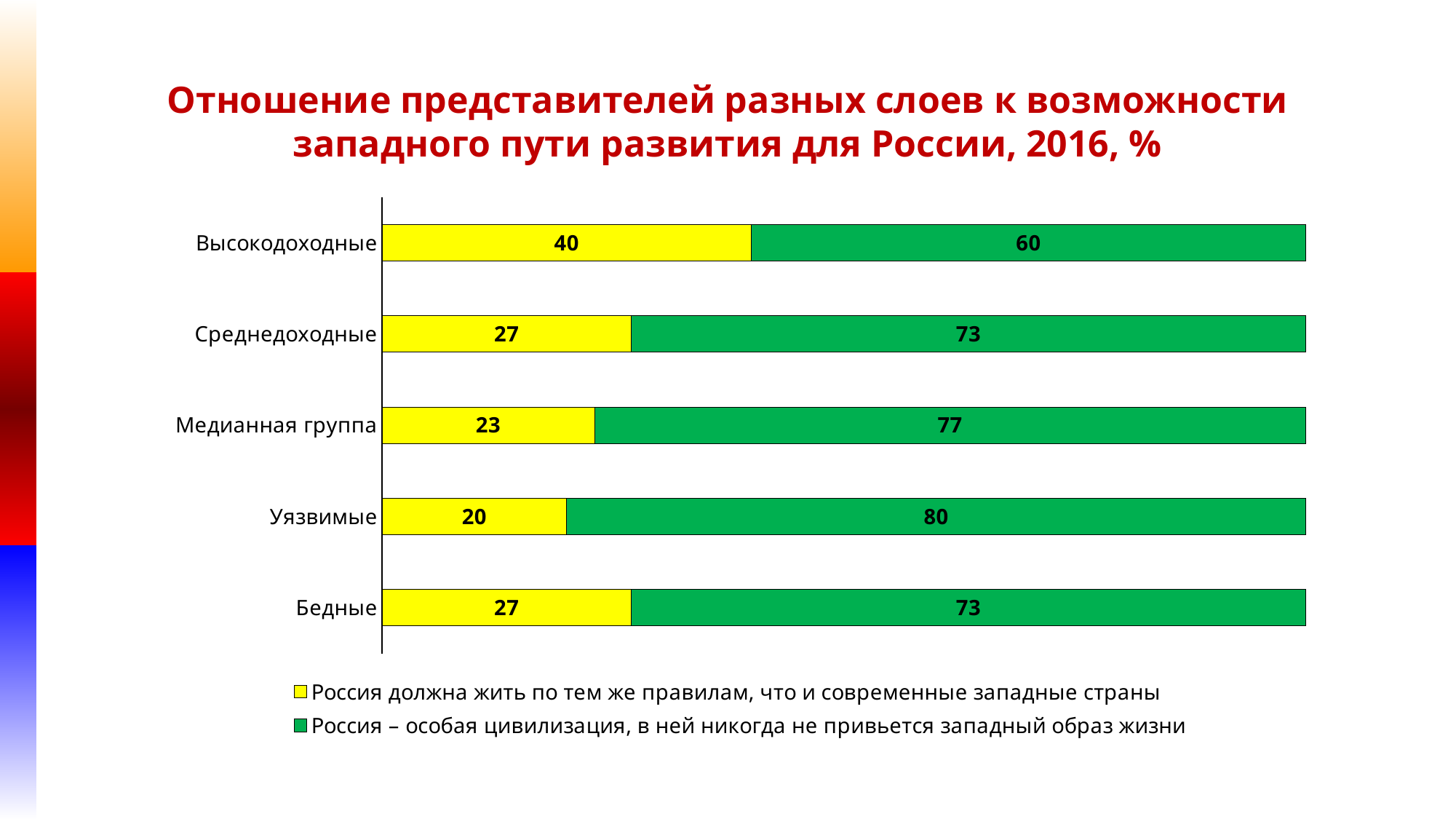
Which category has the highest value for 'Россия – особая цивилизация, в ней никогда не привьется западный образ жизни'? Уязвимые What value is shown for Медианная группа in the yellow series? 23 What kind of chart is shown on the slide? Stacked bar chart What is the total of the stacked bar for Бедные? 100 How many series does the legend list? 2 Which category has the lowest value for 'Россия должна жить по тем же правилам, что и современные западные страны'? Уязвимые What value is shown for Уязвимые in the series 'Россия – особая цивилизация, в ней никогда не привьется западный образ жизни'? 80 Which is larger: the yellow value for Среднедоходные or the yellow value for Медианная группа? Среднедоходные What value is shown for Высокодоходные in the series 'Россия должна жить по тем же правилам, что и современные западные страны'? 40 Which category has the highest value for 'Россия должна жить по тем же правилам, что и современные западные страны'? Высокодоходные How many categories are shown on the chart? 5 What is the difference between the green values for Уязвимые and Высокодоходные? 20